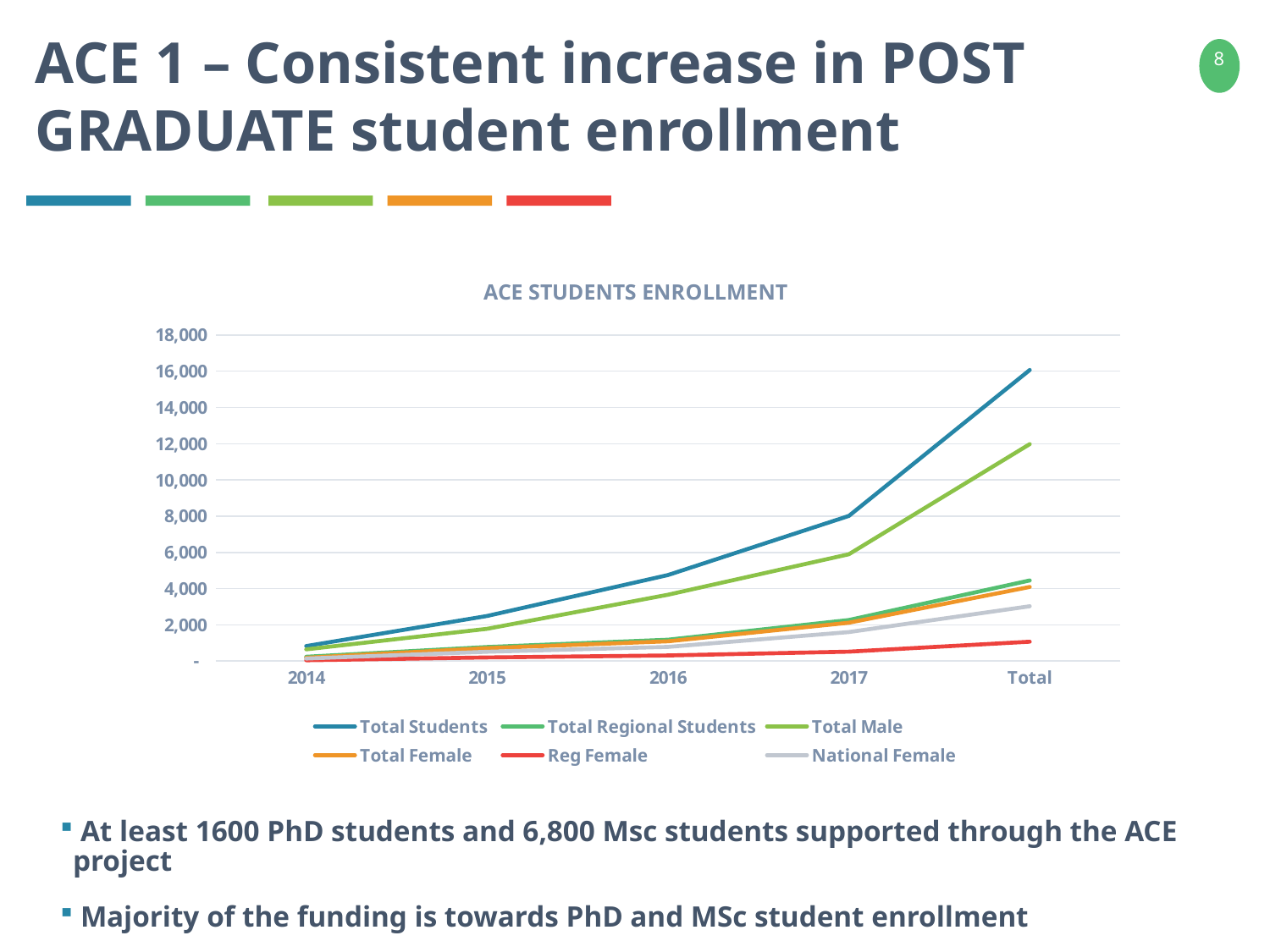
Is the value for Total Male at Total greater or less than 10,000? greater What kind of chart is shown on the slide? line chart Which series has the highest value at the Total category? Total Students Does the Total Students line rise or fall from 2014 to 2017? rise Which series has the lowest value at the Total category? Reg Female How many series does the chart legend list? 6 What is the title of the chart? ACE STUDENTS ENROLLMENT How many categories are shown along the x axis? 5 Is the value for Reg Female at Total greater or less than 2,000? less Is the value for Total Students in 2017 greater or less than 6,000? greater In 2017, which is larger: Total Male or Total Female? Total Male